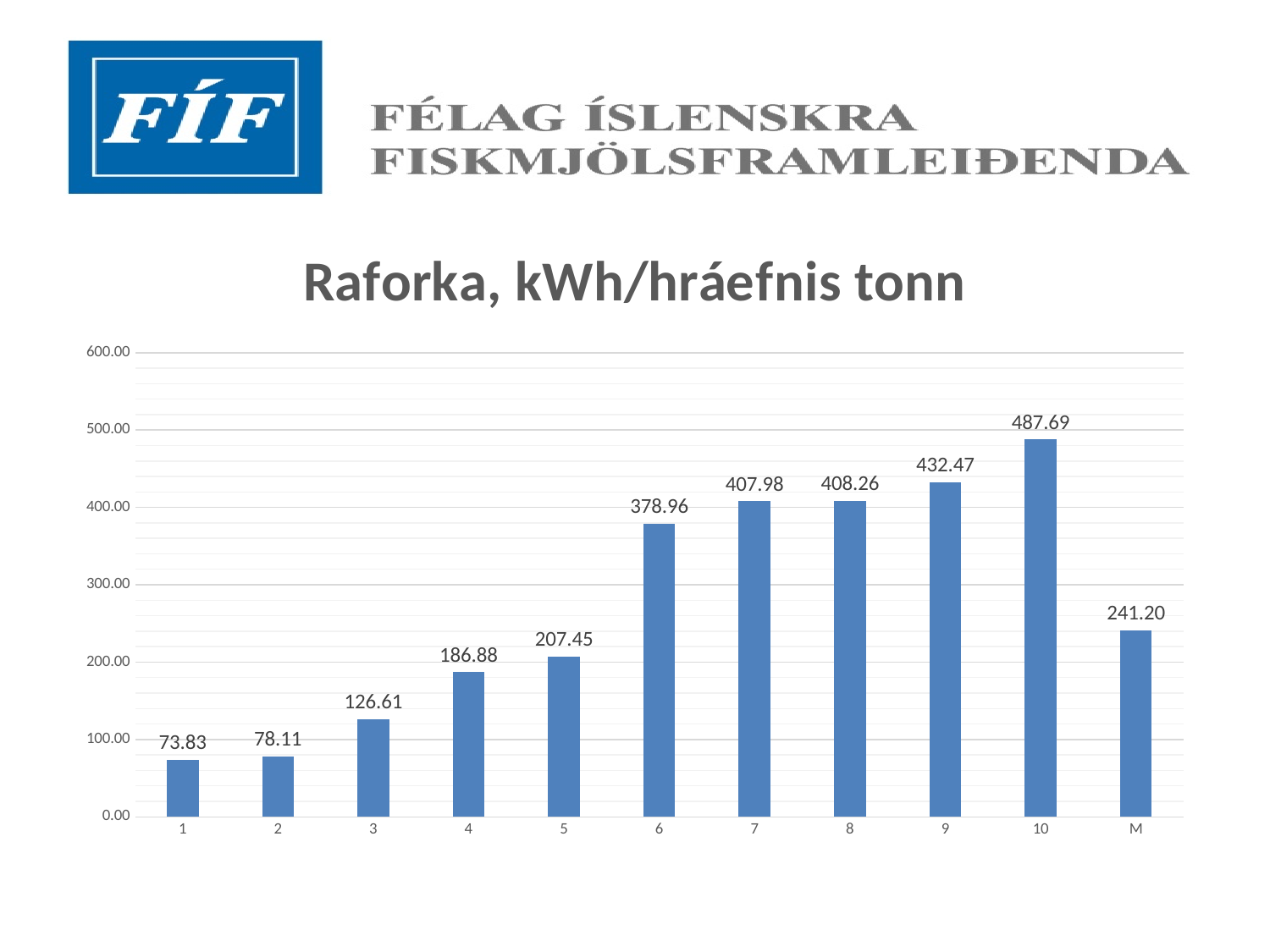
Which category has the highest value? 10 Which category has the lowest value? 1 What is the difference between the values for category 10 and category 9? 55.22 What kind of chart is shown? bar chart What is the title of the chart? Raforka, kWh/hráefnis tonn Which is larger, the value for category 5 or the value for category 4? 5 What is the value for category 3? 126.61 Is the value for category 9 greater or less than 400.00? greater What is the difference between the values for category 2 and category 1? 4.28 What is the value for category 6? 378.96 How many categories are shown on the x axis? 11 What is the value for category M? 241.20